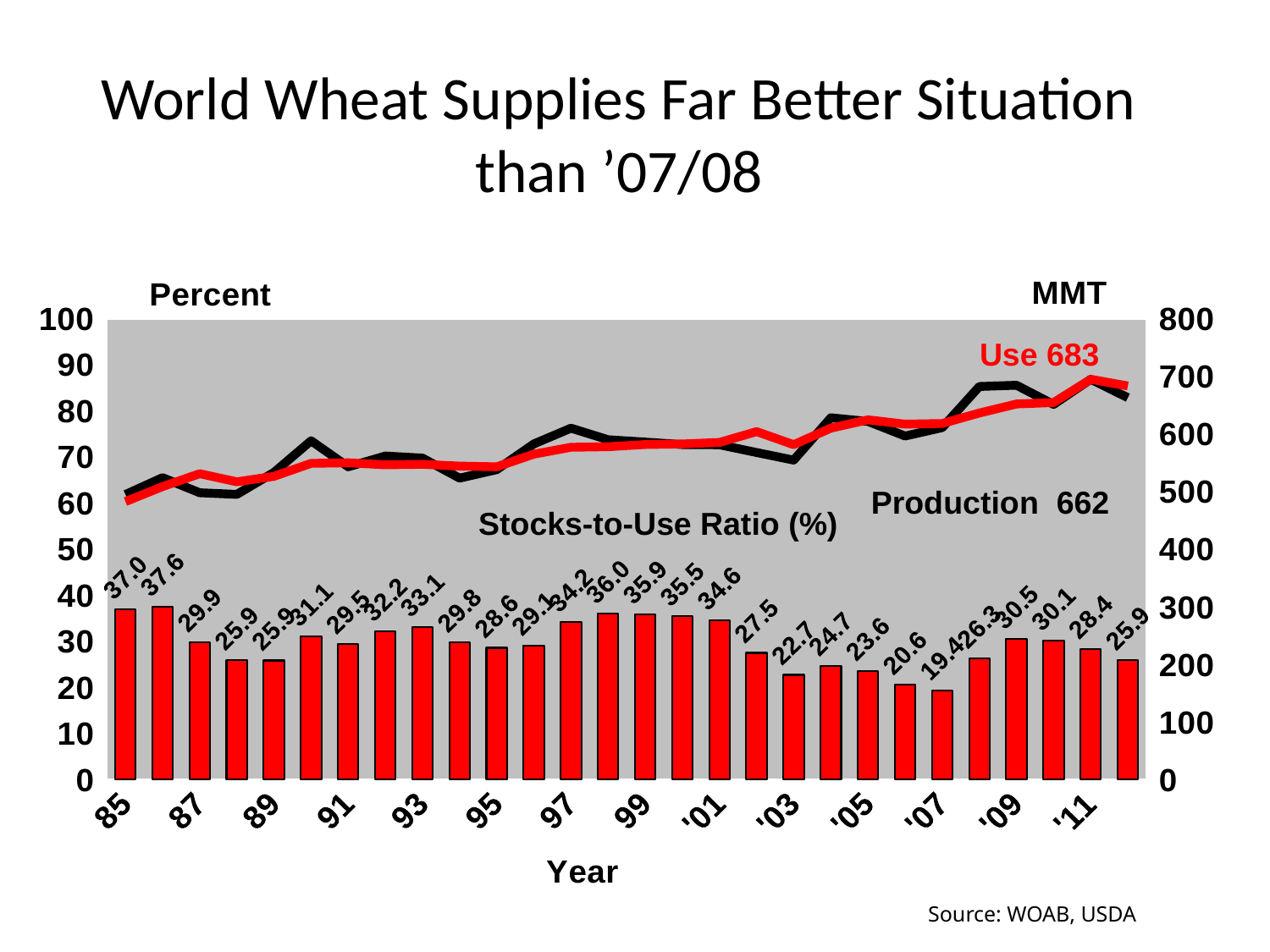
What is the Stocks-to-Use Ratio (%) for '07? 19.4 What is the Stocks-to-Use Ratio (%) for '85? 37.0 What kind of chart is this? Combination bar and line chart Which year has the highest Stocks-to-Use Ratio (%)? '86 What is the final Use value labelled on the chart, in MMT? 683 What is the difference between the highest Stocks-to-Use Ratio (37.6 in '86) and the lowest (19.4 in '07)? 18.2 Which year has a larger Stocks-to-Use Ratio, '97 or '03? '97 How many years are shown as bars for the Stocks-to-Use Ratio? 28 What is the final Production value labelled on the chart, in MMT? 662 What is the Stocks-to-Use Ratio (%) for '98? 36.0 Which year has the lowest Stocks-to-Use Ratio (%)? '07 Is the Production value for '08 greater or less than 600 MMT? greater